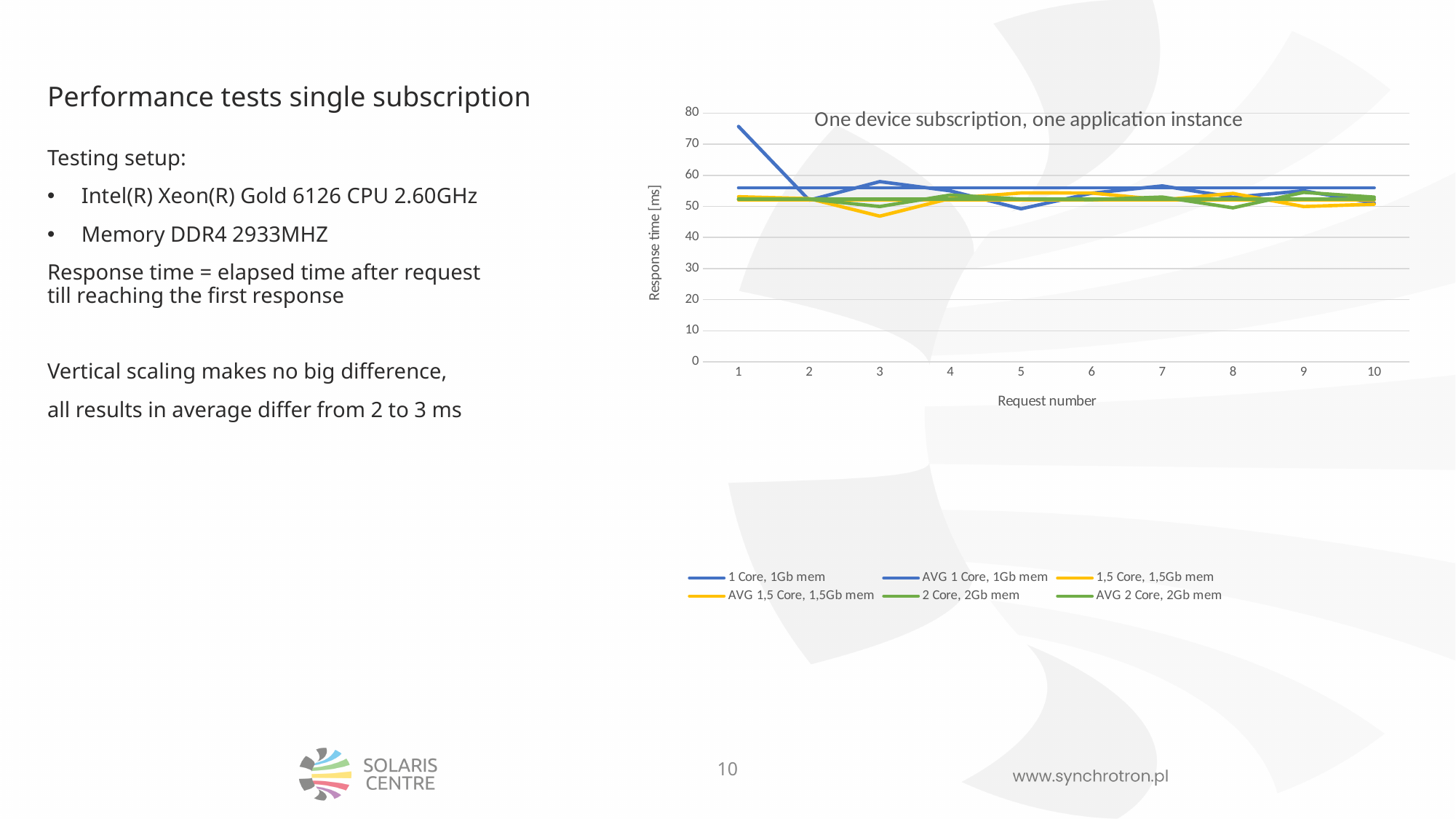
Does the '1 Core, 1Gb mem' series rise or fall from request number 1 to request number 2? fall At request number 1, which series has the larger value: '1 Core, 1Gb mem' or '1,5 Core, 1,5Gb mem'? 1 Core, 1Gb mem At which request number does the '1 Core, 1Gb mem' series reach its highest value? 1 Is the value for '2 Core, 2Gb mem' at request number 2 greater or less than 40? greater Is the value for '1 Core, 1Gb mem' at request number 1 greater or less than 70? greater What kind of chart is shown on the slide? line chart Is the value for 'AVG 1 Core, 1Gb mem' greater or less than 60? less How many request numbers are plotted along the x axis of the chart? 10 How many series does the legend of the chart list? 6 What is the title of the chart? One device subscription, one application instance What is the label of the vertical axis of the chart? Response time [ms]